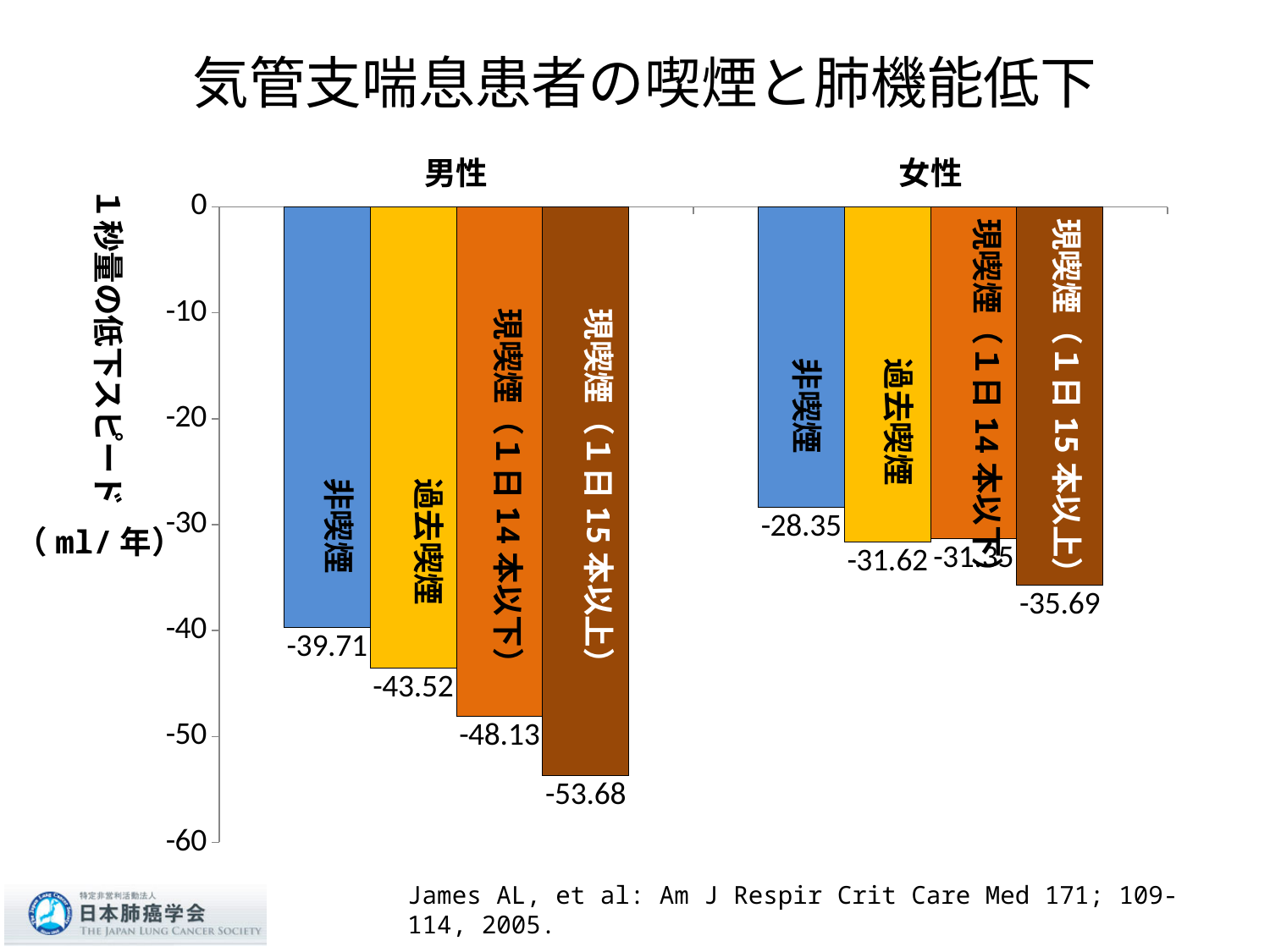
What is the value for 現喫煙（1日15本以上） in the 男性 group? -53.68 What is the value for 過去喫煙 in the 男性 group? -43.52 What is the value for 非喫煙 in the 男性 group? -39.71 What is the value for 現喫煙（1日15本以上） in the 女性 group? -35.69 Which group has the more negative value for 非喫煙, 男性 or 女性? 男性 What type of chart is shown on the slide? Bar chart Which bar shows the lowest (most negative) value on the chart? 現喫煙（1日15本以上） in the 男性 group How many bars are plotted on the chart in total? 8 What is the value for 現喫煙（1日14本以下） in the 男性 group? -48.13 What is the value for 非喫煙 in the 女性 group? -28.35 What is the difference between the 女性 values for 非喫煙 and 現喫煙（1日15本以上）? 7.34 What is the difference between the 男性 values for 非喫煙 and 現喫煙（1日15本以上）? 13.97